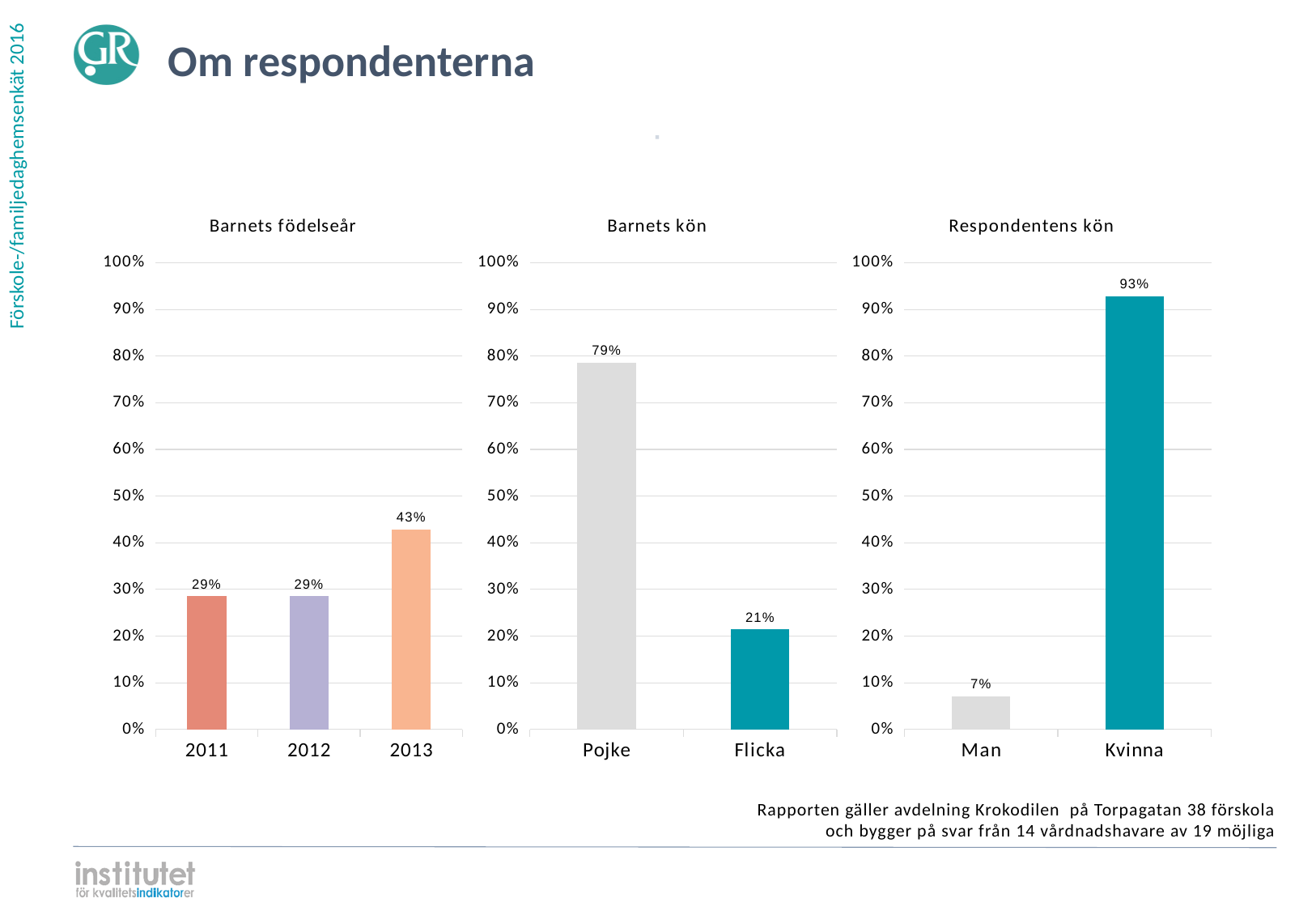
In the 'Respondentens kön' chart, which is larger, Man or Kvinna? Kvinna In the 'Barnets födelseår' chart, what is the value for 2013? 43% In the 'Barnets födelseår' chart, which birth year has the highest value? 2013 In the 'Respondentens kön' chart, what is the value for Man? 7% In the 'Barnets kön' chart, what is the difference between Pojke and Flicka? 58% In the 'Barnets kön' chart, what is the value for Pojke? 79% In the 'Respondentens kön' chart, what is the value for Kvinna? 93% In the 'Barnets födelseår' chart, how many categories are shown on the x axis? 3 What kind of chart is the 'Respondentens kön' chart? Bar chart In the 'Barnets kön' chart, which category is lowest? Flicka In the 'Barnets kön' chart, what is the value for Flicka? 21% In the 'Barnets födelseår' chart, what is the difference between the values for 2013 and 2011? 14%